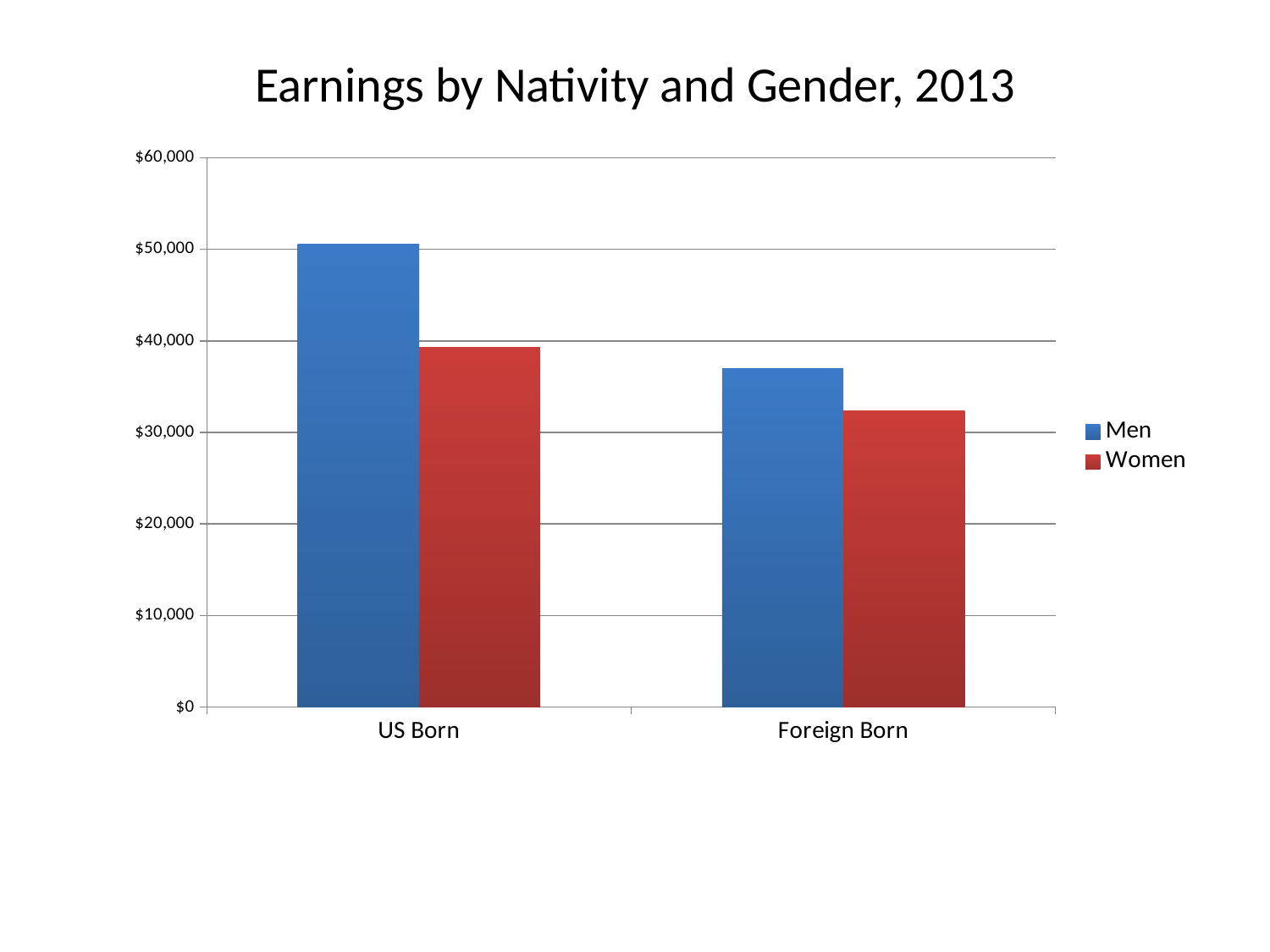
Is the value for Foreign Born Women greater or less than $30,000? greater What is the title of the chart? Earnings by Nativity and Gender, 2013 Which group has the highest earnings bar on the chart? US Born Men What kind of chart is shown on the slide? bar chart Which colour represents Women in the chart? red Which is larger, the earnings of US Born Women or Foreign Born Men? US Born Women Which group has the lowest earnings bar on the chart? Foreign Born Women How many series does the legend list? 2 Is the value for US Born Women greater or less than $40,000? less Is the value for Foreign Born Men greater or less than $40,000? less How many categories are shown on the x axis? 2